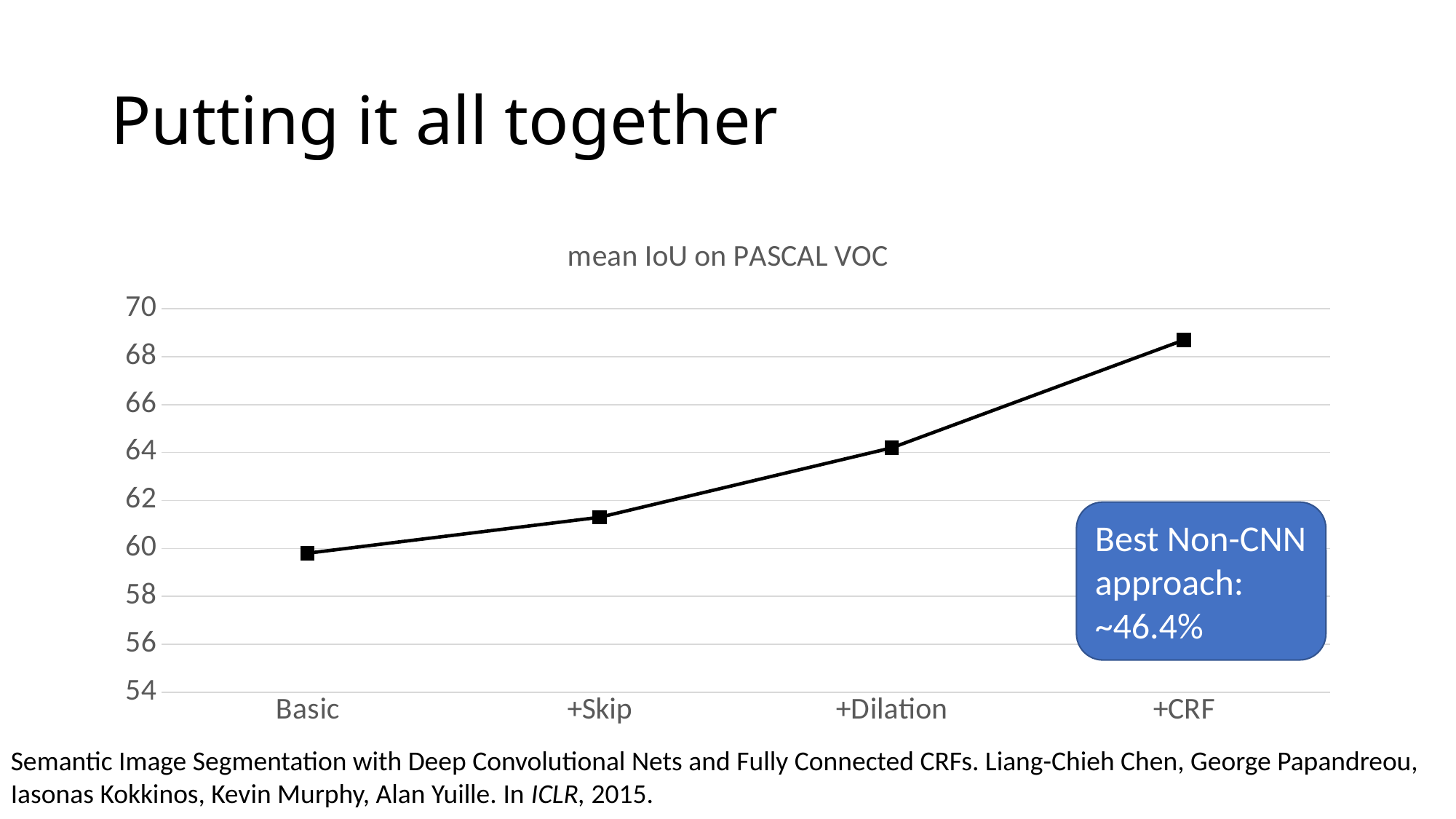
Is the value for +CRF greater or less than 66? greater Do the values rise or fall from Basic to +CRF along the x axis? rise Which has a higher mean IoU, +Skip or +Dilation? +Dilation What is the title of the chart? mean IoU on PASCAL VOC Which category has the lowest mean IoU? Basic Which has a lower mean IoU, Basic or +CRF? Basic Is the value for +Skip greater or less than 60? greater Which category has the highest mean IoU? +CRF How many categories are plotted along the x axis? 4 What kind of chart is shown on the slide? line chart Is the value for Basic greater or less than 58? greater